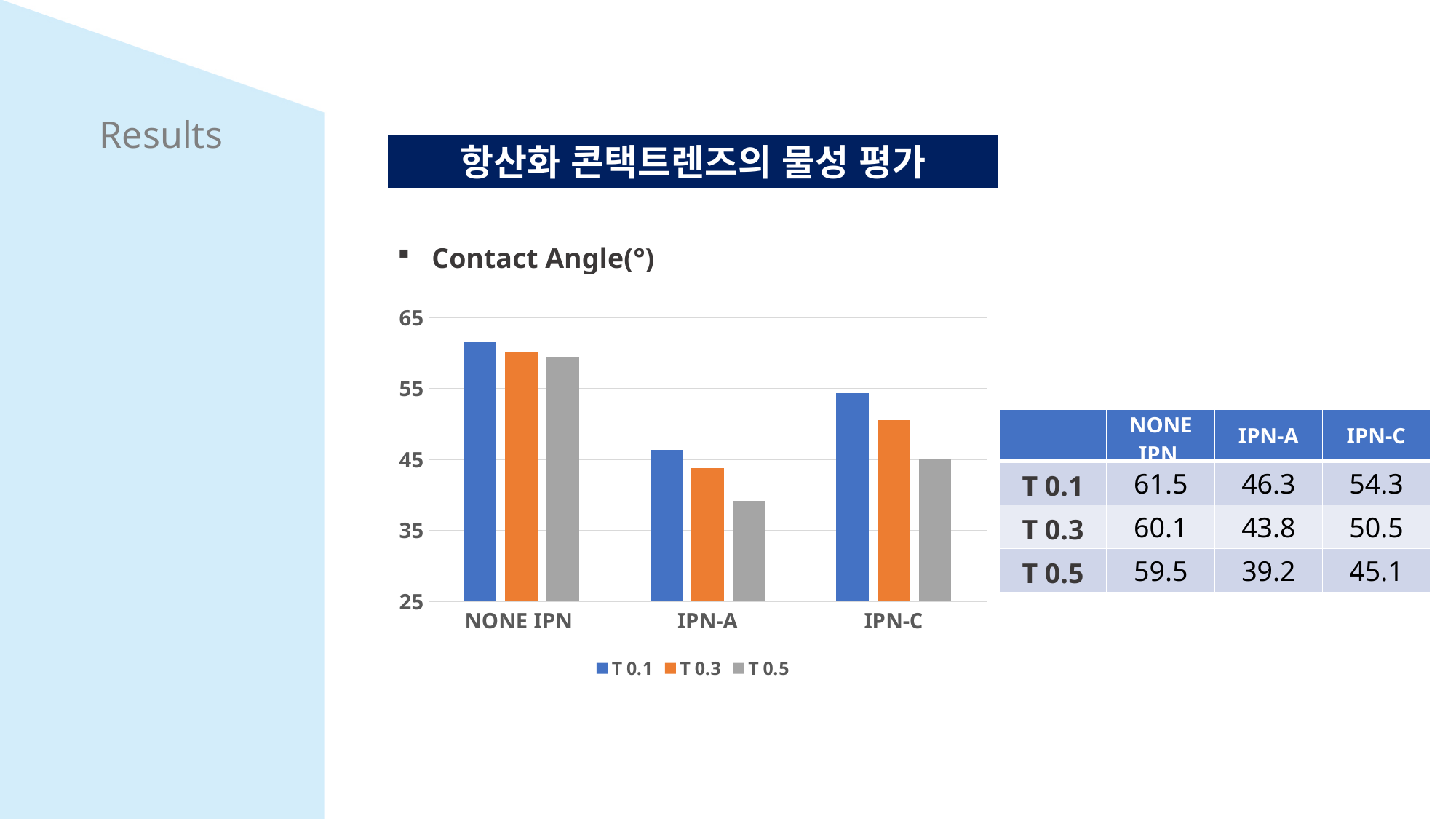
What is the difference between the T 0.1 and T 0.5 contact angles for IPN-C? 9.2 What is the contact angle for IPN-C in the T 0.3 series? 50.5 Which category has the highest contact angle in the T 0.1 series? NONE IPN What is the contact angle for IPN-A in the T 0.5 series? 39.2 What is the contact angle for NONE IPN in the T 0.1 series? 61.5 Is the T 0.1 value for IPN-A greater or less than 45? greater How many series does the legend list? 3 What type of chart is shown on the slide? bar chart Which is larger, the T 0.3 value for IPN-A or the T 0.3 value for IPN-C? IPN-C Which colour represents the T 0.3 series in the chart? orange How many categories are shown on the x axis of the chart? 3 Which category has the lowest contact angle in the T 0.5 series? IPN-A